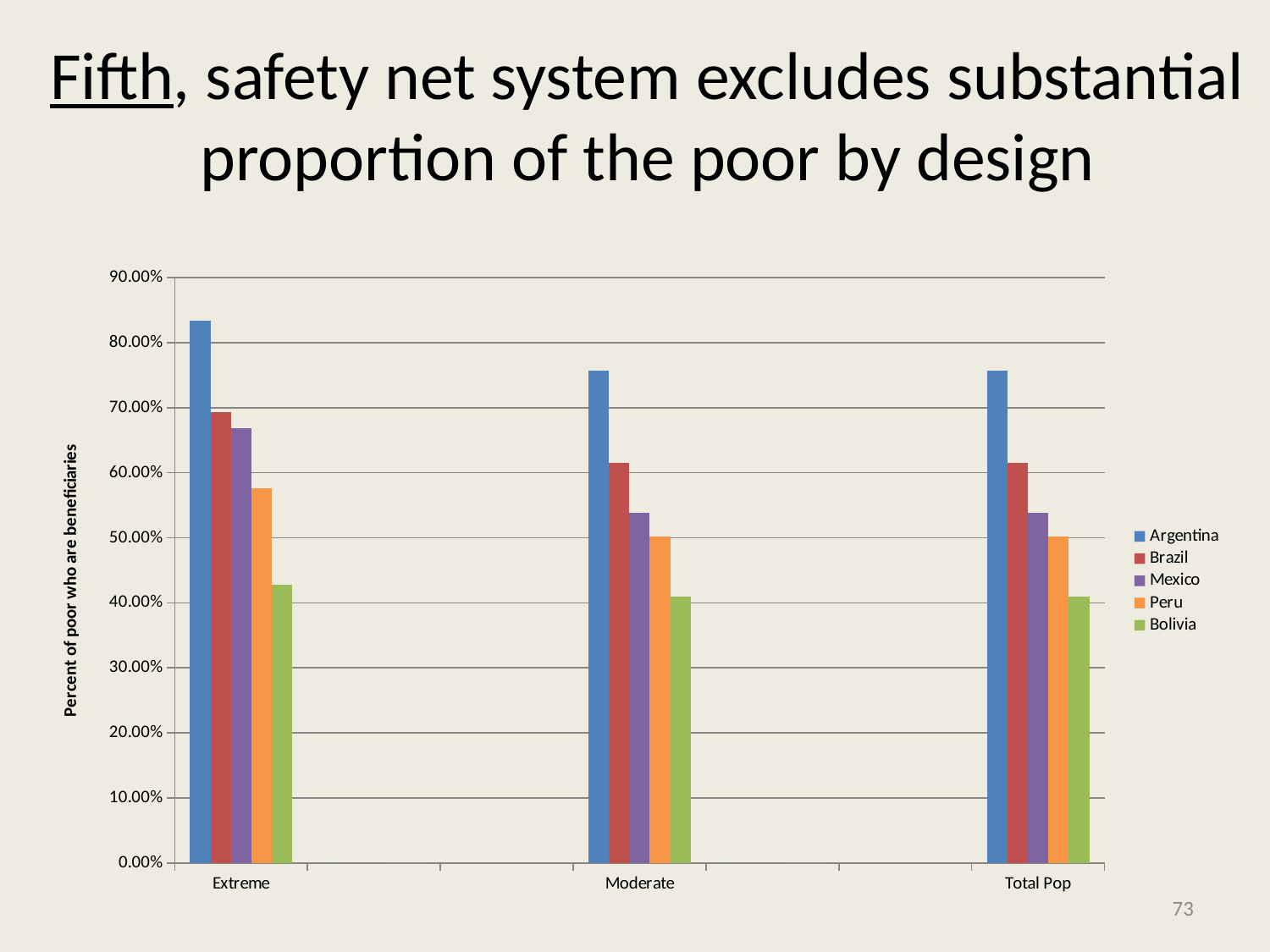
How many series does the legend list? 5 Which country has the lowest value in the Extreme category? Bolivia What is the label on the vertical axis of the chart? Percent of poor who are beneficiaries Is the value for Mexico in the Moderate category greater or less than 60.00%? less How many categories are shown on the x axis? 3 Is the value for Argentina in the Extreme category larger or smaller than the value for Argentina in the Moderate category? larger Which country has the highest value in the Extreme category? Argentina Which country has the lowest value in the Total Pop category? Bolivia Is the value for Peru in the Extreme category larger or smaller than the value for Bolivia in the Extreme category? larger Is the value for Argentina in the Extreme category greater or less than 80.00%? greater What kind of chart is shown on the slide? bar chart Is the value for Bolivia in the Extreme category greater or less than 50.00%? less